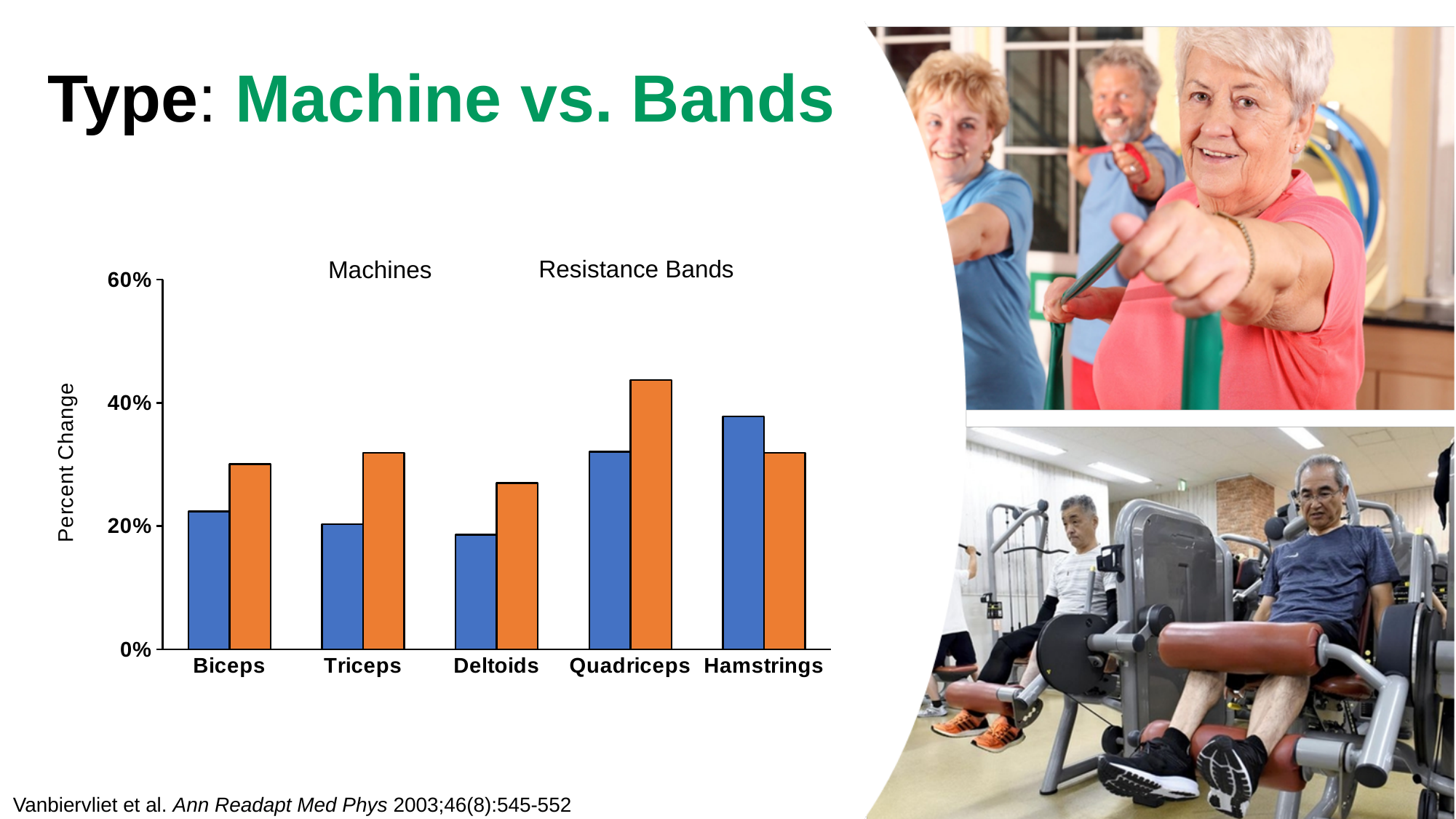
Which muscle group has the highest Machines value? Hamstrings Which muscle group has the highest Resistance Bands value? Quadriceps Is the Machines value for Hamstrings greater or less than 40%? less How many muscle groups are shown on the x axis of the chart? 5 For Hamstrings, which is larger: the Machines value or the Resistance Bands value? Machines How many series does the chart's legend list? 2 Is the Machines value for Deltoids greater or less than 20%? less What kind of chart is shown on the slide? Bar chart For Biceps, which is larger: the Machines value or the Resistance Bands value? Resistance Bands What is the label on the y axis of the chart? Percent Change What are the two series named in the chart's legend? Machines and Resistance Bands Is the Resistance Bands value for Quadriceps greater or less than 40%? greater